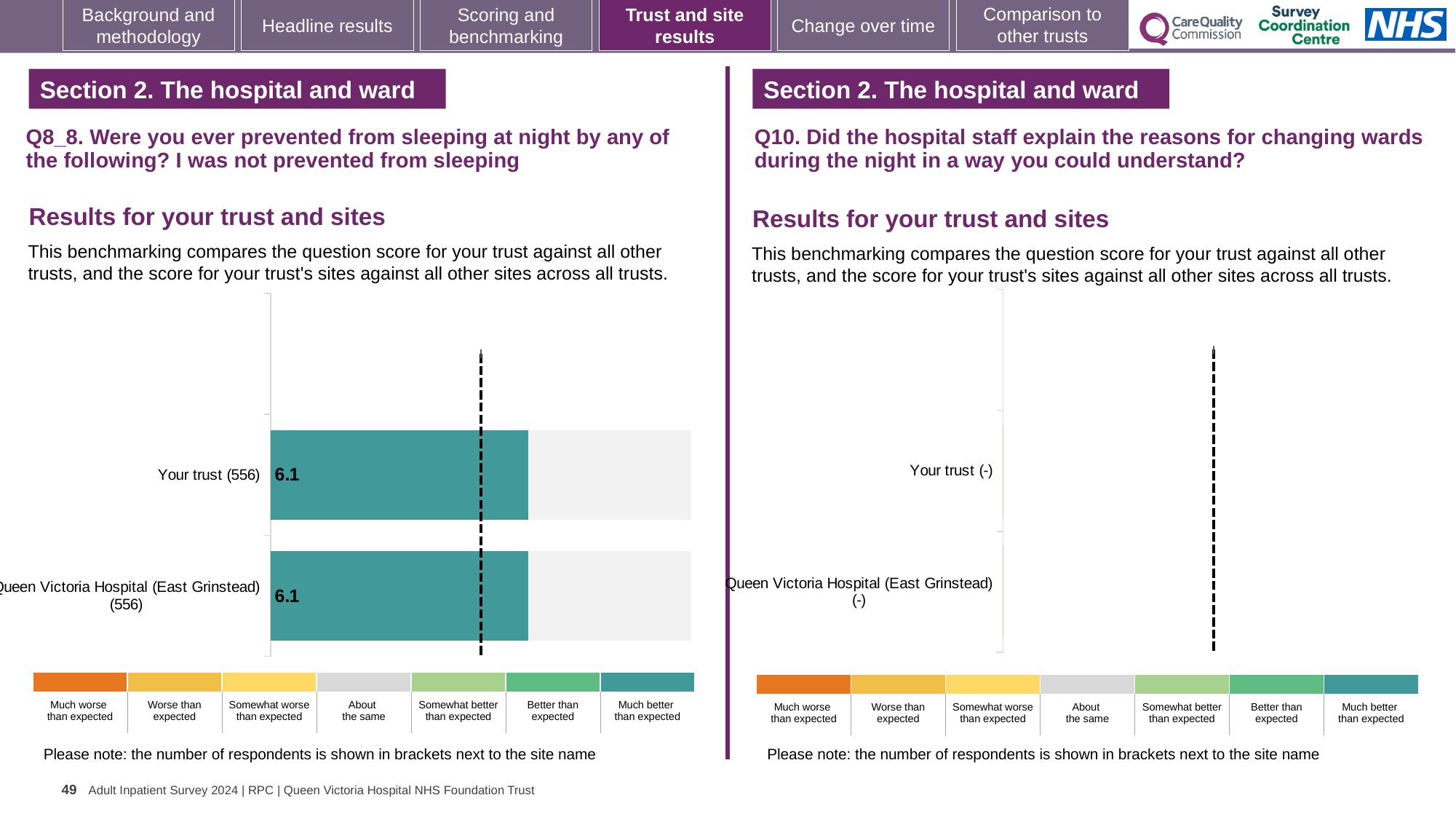
In the Q8_8 chart on the left, what is the score for Queen Victoria Hospital (East Grinstead)? 6.1 What kind of chart is the Q8_8 chart on the left? Bar chart In the Q8_8 chart on the left, how many respondents are shown in brackets next to Queen Victoria Hospital (East Grinstead)? 556 In the Q8_8 chart on the left, how many respondents are shown in brackets next to Your trust? 556 In the Q10 chart on the right, how many category labels are listed on the vertical axis? 2 In the Q8_8 chart on the left, what is the score for Your trust? 6.1 In the Q10 chart on the right, how many respondents are shown in brackets next to Your trust? - How many benchmark categories does the colour legend below the Q8_8 chart on the left list? 7 In the Q8_8 chart on the left, what is the difference between the score for Your trust and the score for Queen Victoria Hospital (East Grinstead)? 0 In the Q8_8 chart on the left, how many bars are plotted? 2 In the Q8_8 chart on the left, which benchmark category does the colour of the plotted bars correspond to in the legend? Much better than expected